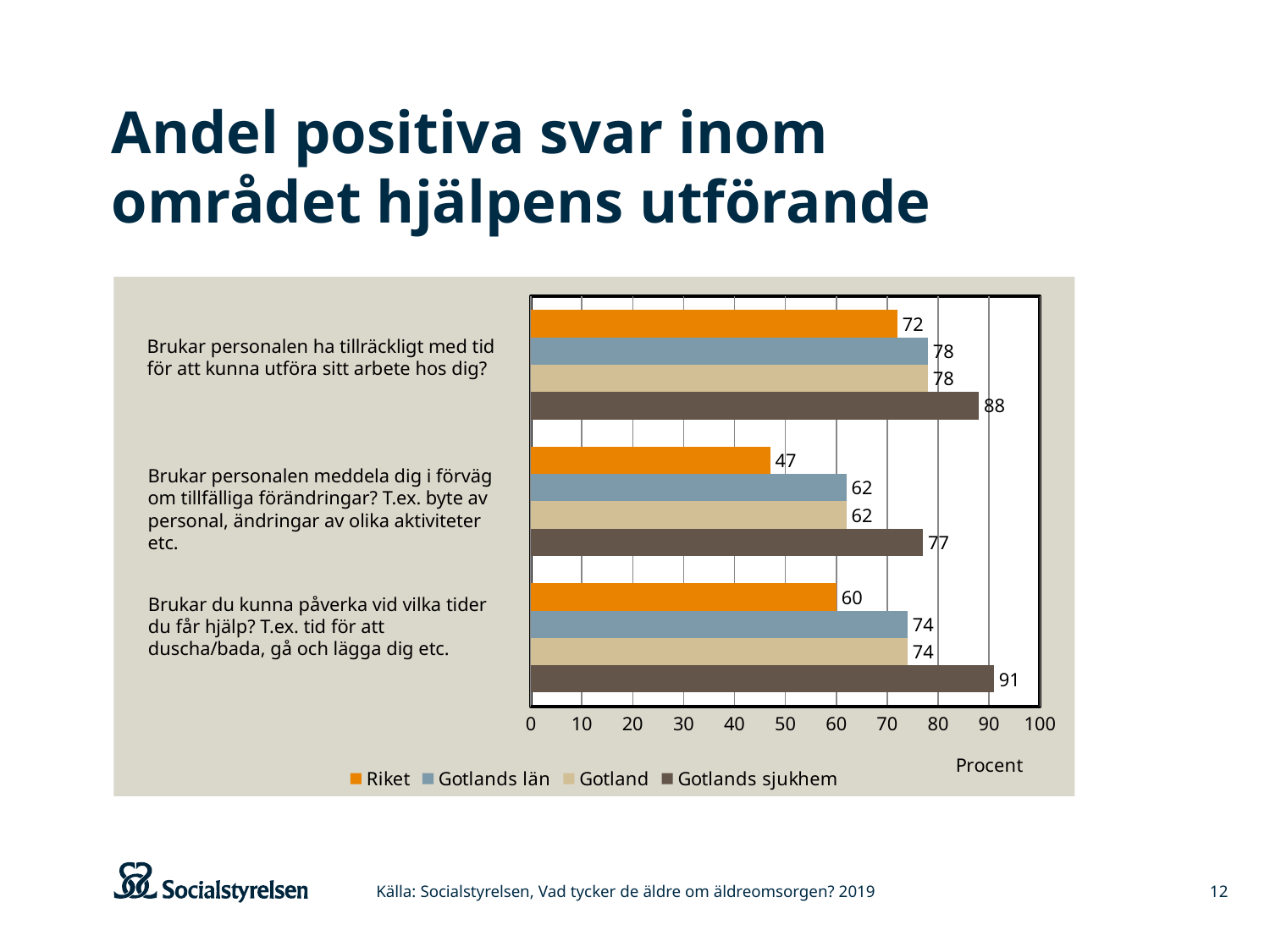
What is the difference between Gotlands sjukhem and Riket on the question "Brukar personalen meddela dig i förväg om tillfälliga förändringar?"? 30 Which series has the highest value on the question "Brukar personalen ha tillräckligt med tid för att kunna utföra sitt arbete hos dig?"? Gotlands sjukhem Which series has the lowest value on the question "Brukar du kunna påverka vid vilka tider du får hjälp?"? Riket What is the label of the horizontal axis? Procent What is the value for Riket on the question "Brukar personalen meddela dig i förväg om tillfälliga förändringar?"? 47 What is the value for Gotlands län on the question "Brukar personalen ha tillräckligt med tid för att kunna utföra sitt arbete hos dig?"? 78 How many questions (categories) are shown on the chart? 3 What is the value for Gotlands sjukhem on the question "Brukar du kunna påverka vid vilka tider du får hjälp?"? 91 Which series is shown in orange in the legend? Riket Which is larger: the Riket value for "Brukar personalen ha tillräckligt med tid..." or the Riket value for "Brukar du kunna påverka vid vilka tider du får hjälp?"? Brukar personalen ha tillräckligt med tid... What kind of chart is shown on the slide? Bar chart How many series does the legend list? 4